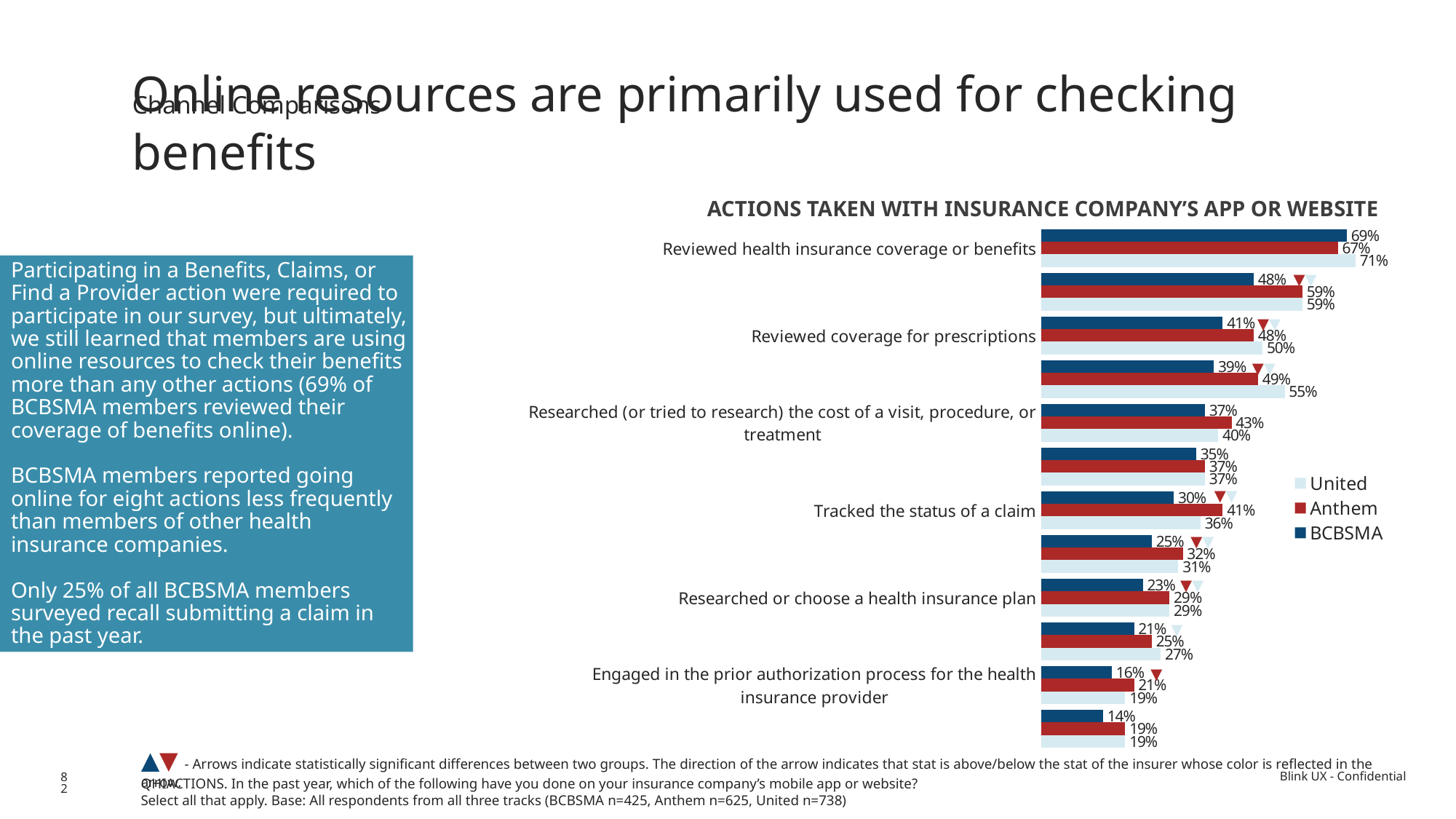
What is the BCBSMA value for 'Reviewed health insurance coverage or benefits'? 69% How many series does the legend list? 3 What is the United value for 'Reviewed health insurance coverage or benefits'? 71% For 'Researched (or tried to research) the cost of a visit, procedure, or treatment', which is larger: the Anthem value or the United value? Anthem Which series has the highest value for 'Reviewed health insurance coverage or benefits'? United What is the difference between the United and BCBSMA values for 'Reviewed coverage for prescriptions'? 9% What is the Anthem value for 'Reviewed coverage for prescriptions'? 48% What is the United value for 'Engaged in the prior authorization process for the health insurance provider'? 19% What is the difference between the Anthem and BCBSMA values for 'Tracked the status of a claim'? 11% What type of chart is shown on the slide? Bar chart What is the BCBSMA value for 'Tracked the status of a claim'? 30% Which series has the lowest value for 'Researched or choose a health insurance plan'? BCBSMA